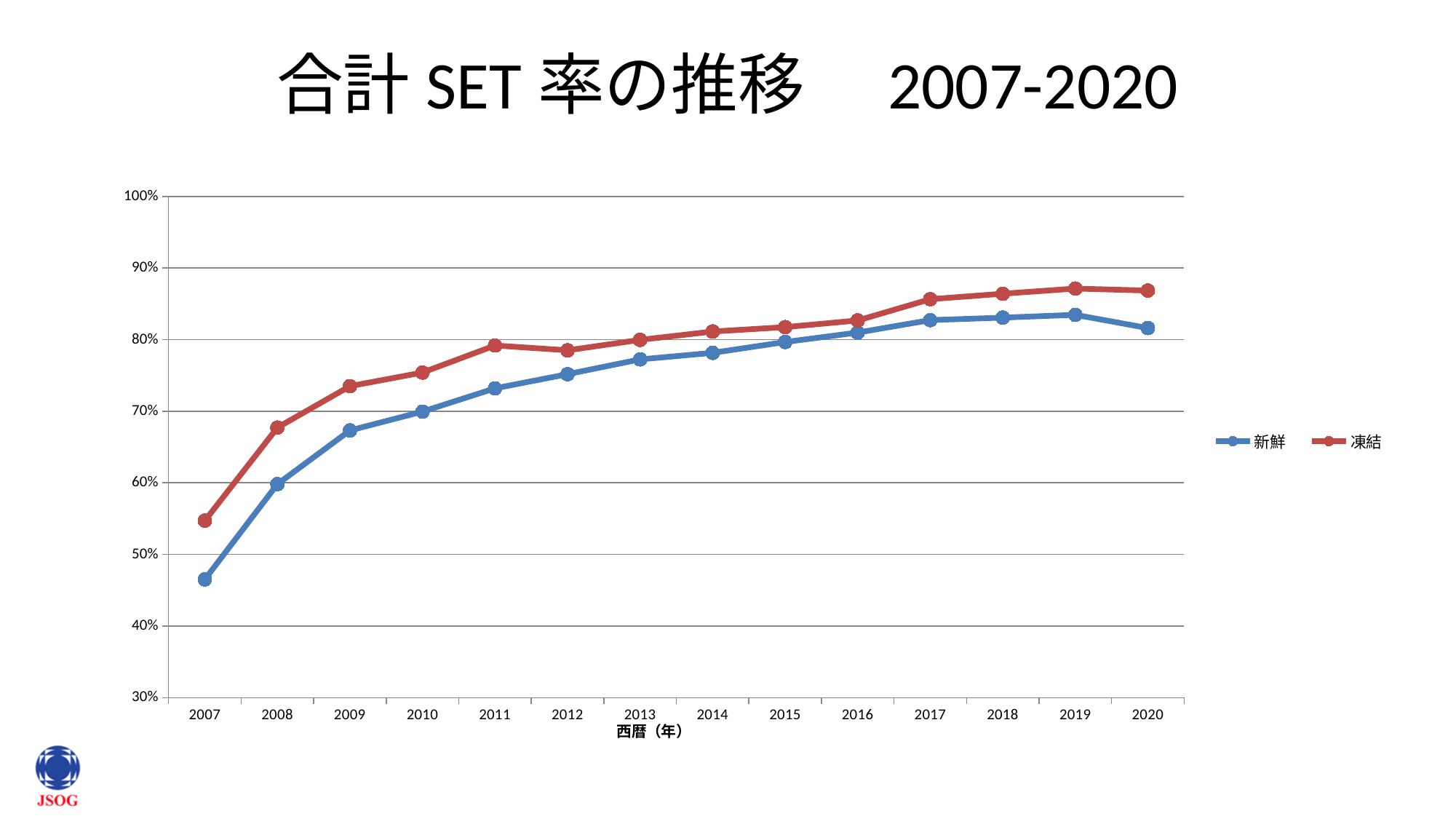
Is the value for 凍結 in 2009 greater or less than 70%? greater In 2020, which series has the higher value, 新鮮 or 凍結? 凍結 What kind of chart is shown on the slide? line chart Is the value for 新鮮 in 2007 greater or less than 50%? less How many years are plotted along the x axis? 14 Is the value for 凍結 in 2019 greater or less than 90%? less Do the values for 凍結 generally rise or fall from 2007 to 2020? rise In which year is the value for 新鮮 lowest? 2007 In 2007, which series has the higher value, 新鮮 or 凍結? 凍結 How many series does the legend list? 2